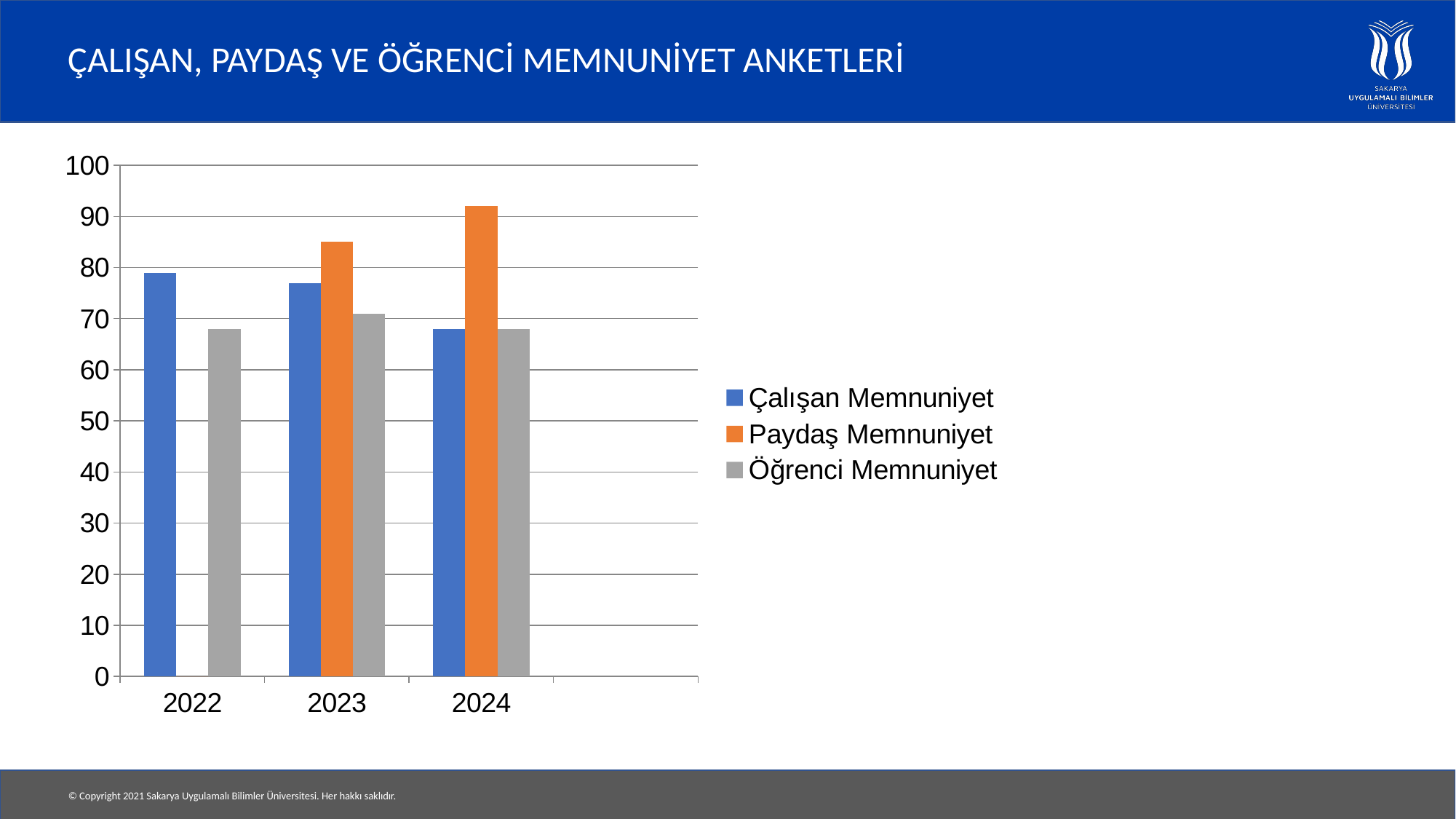
What kind of chart is shown on the slide? bar chart Is the value for Çalışan Memnuniyet in 2022 greater or less than 70? greater Which is larger, Paydaş Memnuniyet in 2024 or Paydaş Memnuniyet in 2023? Paydaş Memnuniyet in 2024 In which year is Çalışan Memmuniyet lowest? 2024 Is the value for Paydaş Memnuniyet in 2023 greater or less than 80? greater How many years are shown on the x axis? 3 How many series does the legend list? 3 Which series has the highest bar in the chart? Paydaş Memnuniyet Which is larger in 2023, Çalışan Memnuniyet or Öğrenci Memnuniyet? Çalışan Memnuniyet Is the value for Öğrenci Memnuniyet in 2024 greater or less than 60? greater Does Çalışan Memnuniyet rise or fall from 2022 to 2024? fall Which series has no bar for 2022? Paydaş Memnuniyet